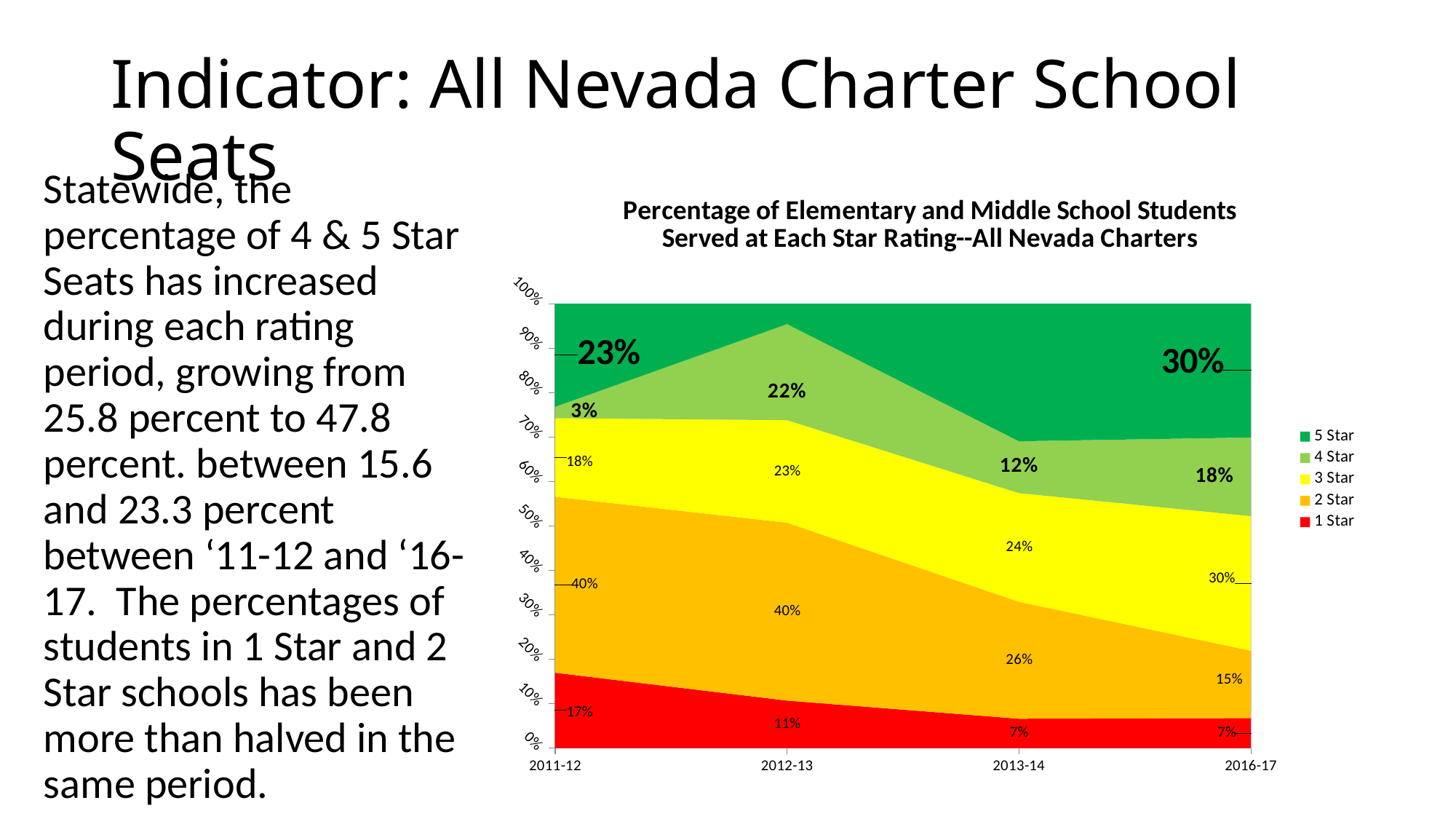
What percentage of students were in 2 Star schools in 2013-14? 26% In which period is the 4 Star percentage lowest? 2011-12 How many series does the legend list? 5 Does the 1 Star percentage rise or fall from 2011-12 to 2013-14? Fall What percentage of students were in 4 Star schools in 2012-13? 22% Which is larger: the 3 Star percentage in 2012-13 or the 3 Star percentage in 2016-17? 2016-17 What percentage of students were in 5 Star schools in 2016-17? 30% What type of chart is shown on the slide? Stacked area chart Which colour represents the 3 Star series in the legend? Yellow How many rating periods are shown on the x axis? 4 What is the difference between the 2 Star percentage in 2011-12 and in 2016-17? 25% What percentage of students were in 1 Star schools in 2011-12? 17%